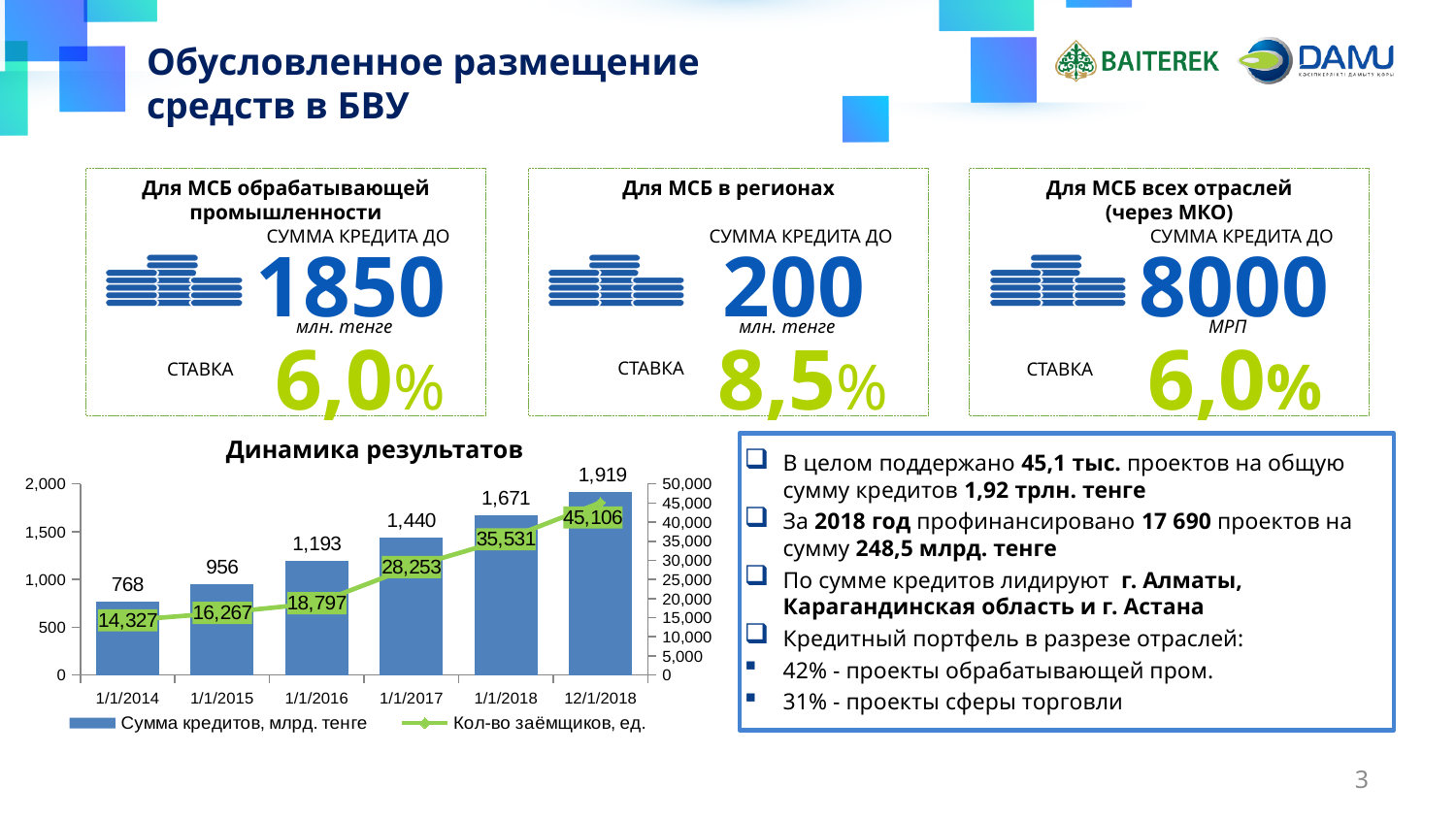
How many dates are shown on the x axis of the chart 'Динамика результатов'? 6 In the chart 'Динамика результатов', which date has the lowest value of 'Кол-во заёмщиков, ед.'? 1/1/2014 In the chart 'Динамика результатов', is the value of 'Сумма кредитов, млрд. тенге' larger for 1/1/2015 or 1/1/2016? 1/1/2016 In the chart 'Динамика результатов', what is the difference in 'Сумма кредитов, млрд. тенге' between 1/1/2018 and 1/1/2017? 231 In the chart 'Динамика результатов', which date has the highest value of 'Сумма кредитов, млрд. тенге'? 12/1/2018 In the chart 'Динамика результатов', what is the difference in 'Кол-во заёмщиков, ед.' between 12/1/2018 and 1/1/2018? 9,575 What is the title of the chart on the slide? Динамика результатов In the chart 'Динамика результатов', what is the value of 'Сумма кредитов, млрд. тенге' for 1/1/2016? 1,193 How many series does the legend of the chart 'Динамика результатов' list? 2 In the chart 'Динамика результатов', what is the value of 'Сумма кредитов, млрд. тенге' for 12/1/2018? 1,919 In the chart 'Динамика результатов', what is the value of 'Кол-во заёмщиков, ед.' for 1/1/2017? 28,253 In the chart 'Динамика результатов', do the values of 'Сумма кредитов, млрд. тенге' rise or fall from 1/1/2014 to 12/1/2018? rise